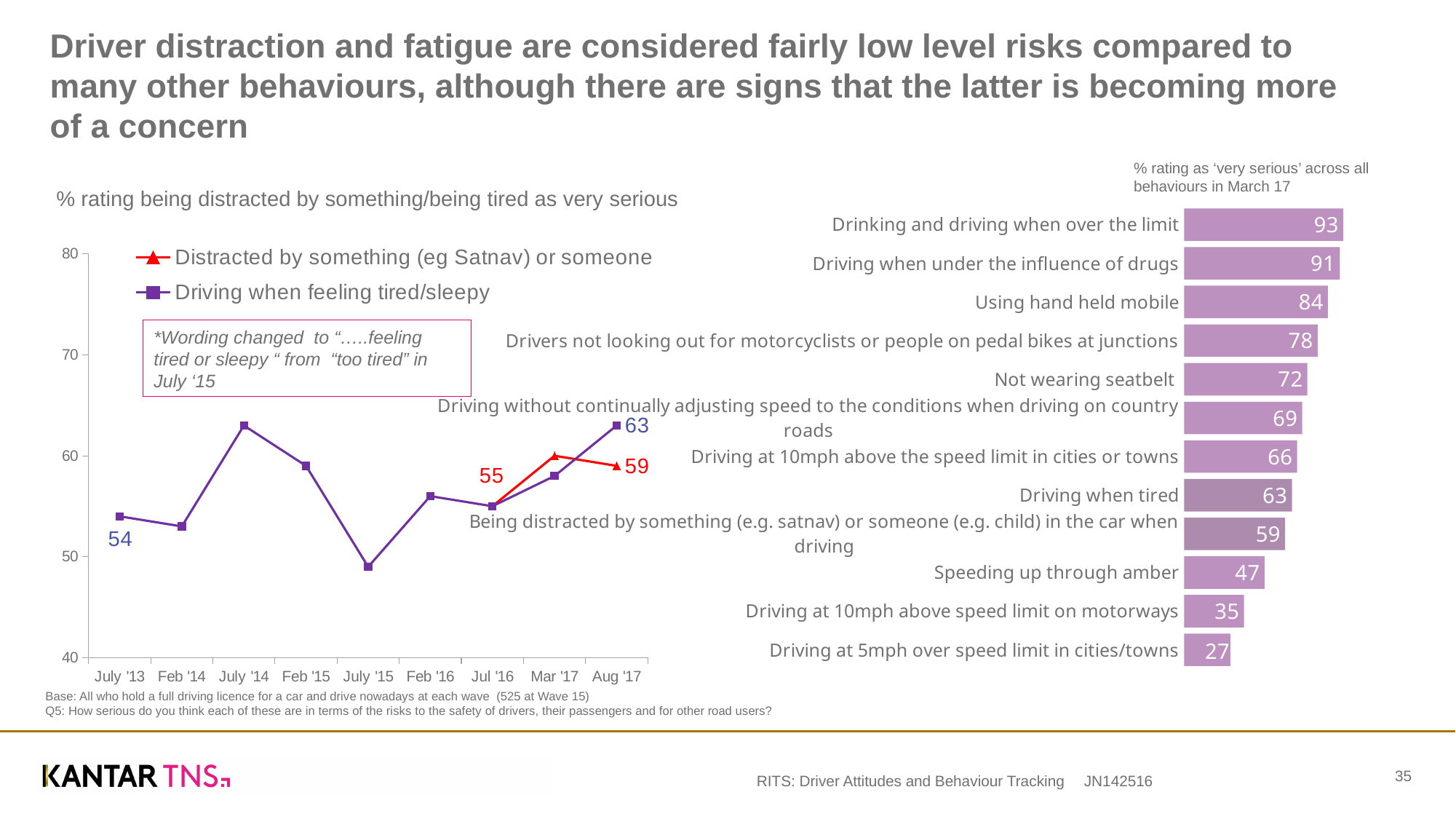
In the line chart on the left, what is the value for 'Distracted by something (eg Satnav) or someone' in Aug '17? 59 What type of chart is shown on the right side of the slide? Bar chart In the bar chart on the right, what is the difference between the values for 'Using hand held mobile' and 'Not wearing seatbelt'? 12 In the bar chart on the right, which behaviour has the highest percentage rating it as very serious? Drinking and driving when over the limit In the bar chart on the right, what percentage rated 'Drinking and driving when over the limit' as very serious? 93 How many behaviours are listed in the bar chart on the right? 12 In the line chart on the left, what is the value for 'Driving when feeling tired/sleepy' in July '13? 54 In the line chart on the left, which series has the higher value in Aug '17? Driving when feeling tired/sleepy In the line chart on the left, what is the value for 'Driving when feeling tired/sleepy' in Aug '17? 63 In the line chart on the left, is the value for 'Driving when feeling tired/sleepy' in July '15 greater or less than 50? less How many series does the legend of the line chart on the left list? 2 In the bar chart on the right, which behaviour has the lowest percentage rating it as very serious? Driving at 5mph over speed limit in cities/towns